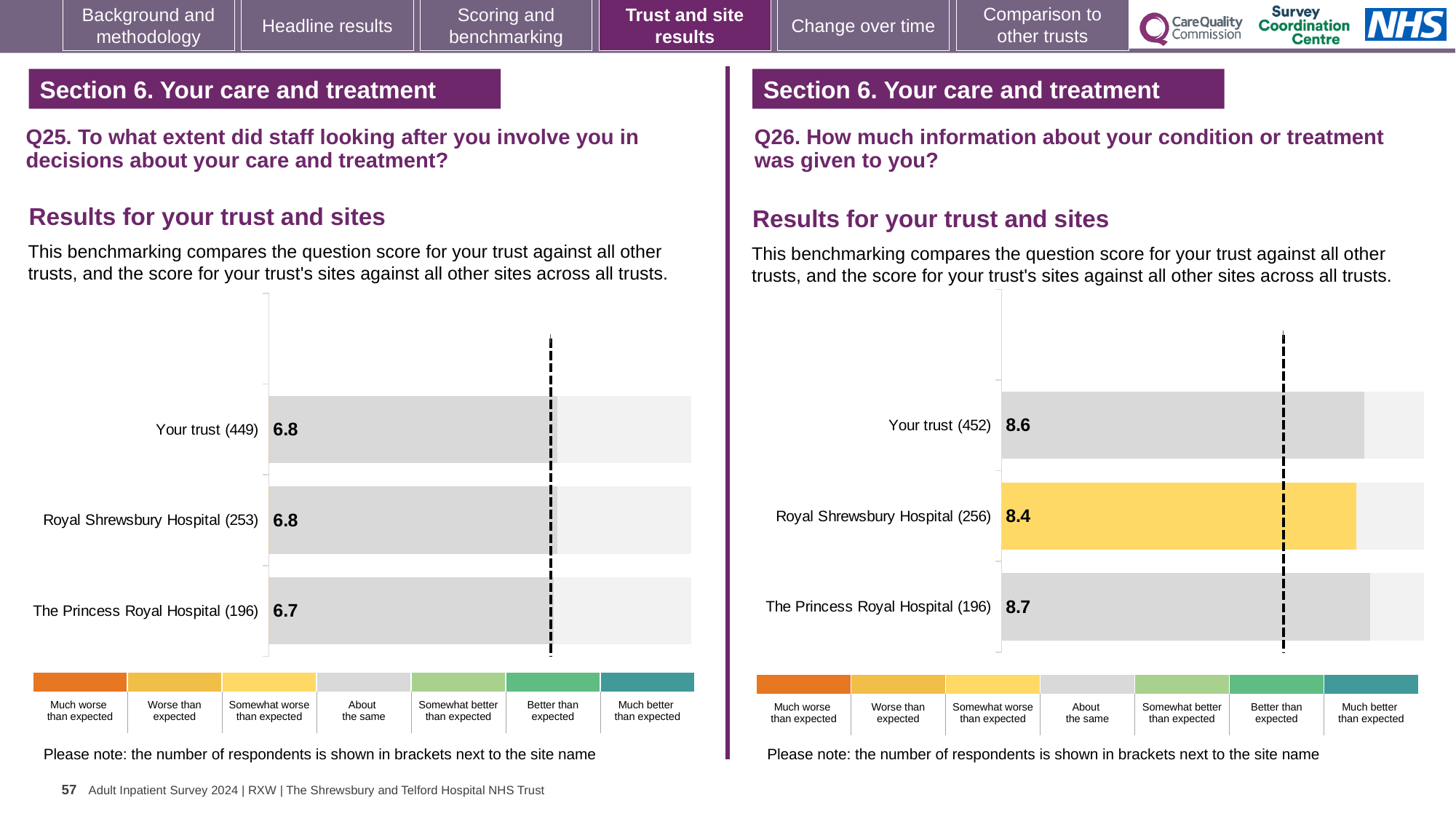
In the Q26 chart on the right, which is larger: the score for Your trust (452) or Royal Shrewsbury Hospital (256)? Your trust (452) How many bars are plotted in the Q25 chart on the left? 3 In the Q26 chart on the right, which site or trust has the lowest score? Royal Shrewsbury Hospital (256) In the Q25 chart on the left, what is the difference between the scores for Your trust and The Princess Royal Hospital? 0.1 In the Q26 chart on the right, which site or trust has the highest score? The Princess Royal Hospital (196) In the Q25 chart on the left, what is the score for The Princess Royal Hospital (196)? 6.7 In the Q26 chart on the right, what is the difference between the scores for The Princess Royal Hospital and Royal Shrewsbury Hospital? 0.3 In the Q26 chart on the right, what is the score for Royal Shrewsbury Hospital (256)? 8.4 In the Q26 chart on the right, what is the score for The Princess Royal Hospital (196)? 8.7 What type of chart is used for the Q26 results on the right? Bar chart In the Q25 chart on the left, which has the lowest score? The Princess Royal Hospital (196) In the Q25 chart on the left, what is the score for Your trust (449)? 6.8